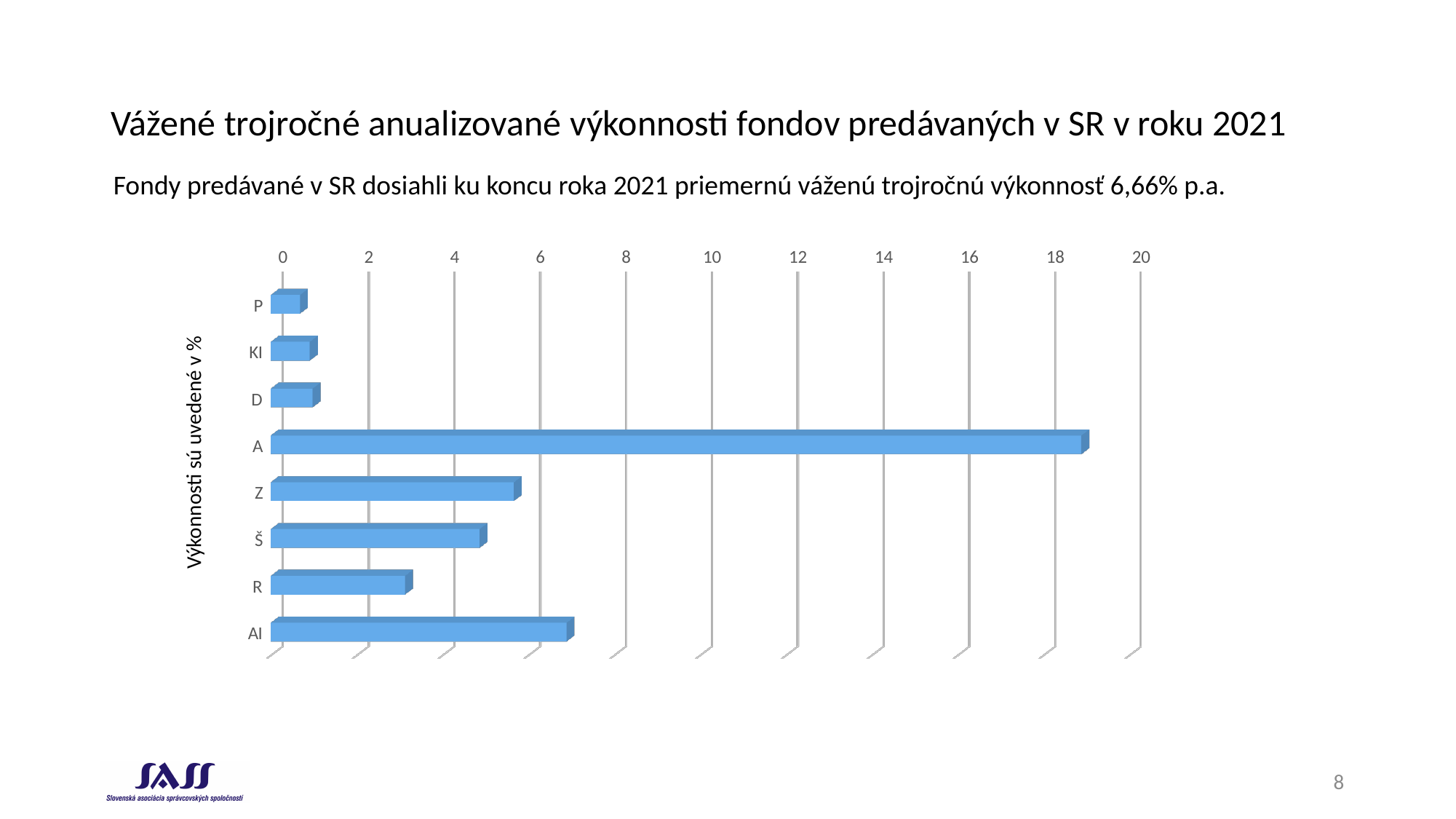
What is the label on the vertical axis of the chart? Výkonnosti sú uvedené v % Which category has the lowest value on the chart? P Which has the larger value, Z or Š? Z Is the value for Š greater or less than 4? greater How many categories are plotted on the chart? 8 What kind of chart is shown on the slide? bar chart Is the value for Z greater or less than 6? less Is the value for R greater or less than 4? less Which category has the highest value on the chart? A Which has the larger value, R or AI? AI